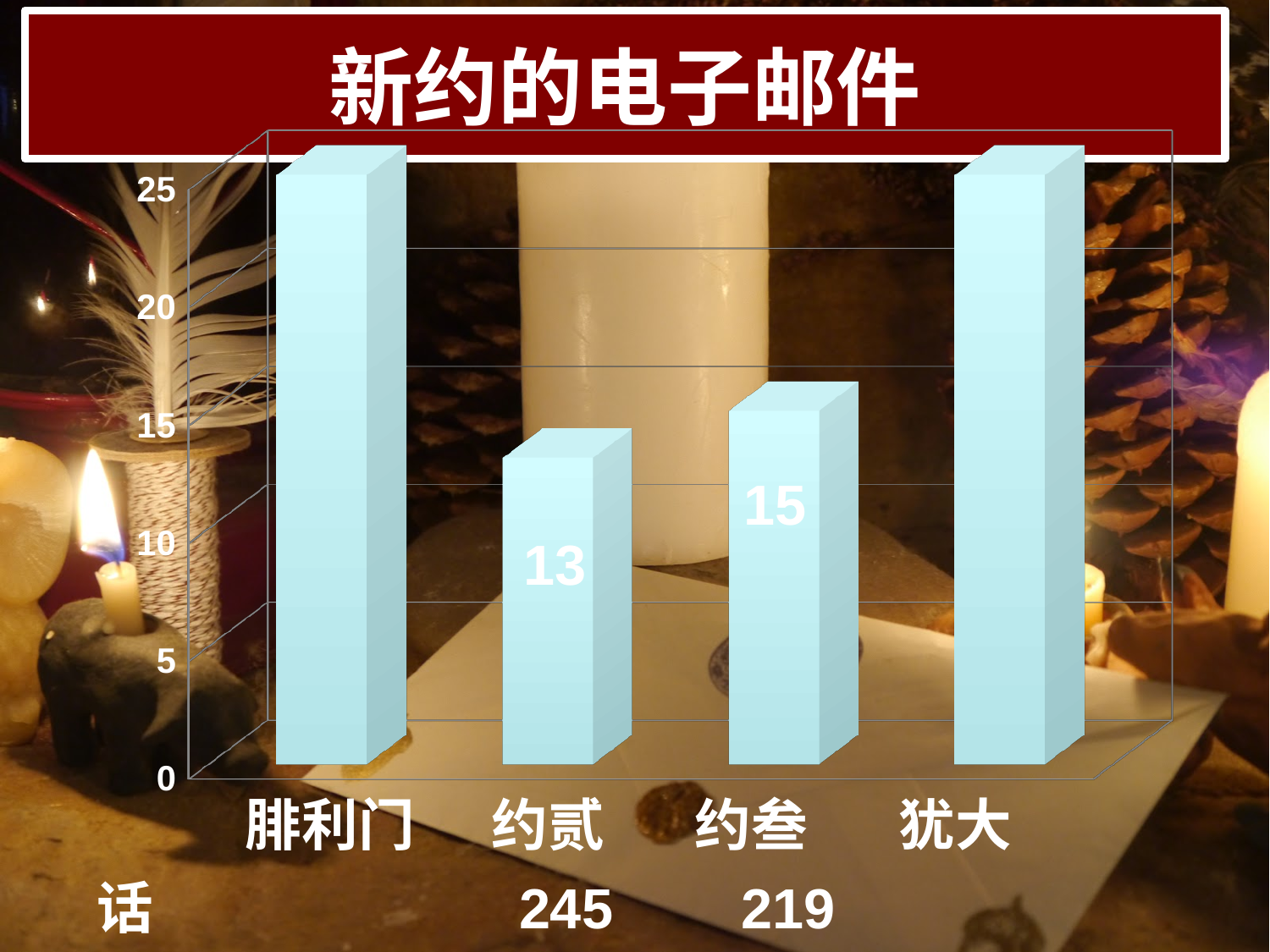
Is the value for 犹大 greater or less than 20? greater What kind of chart is shown on the slide? bar chart What is the value for 约叁? 15 How many categories are shown on the x axis? 4 What is the highest value shown on the vertical axis? 25 What is the difference between the values for 约叁 and 约贰? 2 Is the value for 腓利门 greater or less than 20? greater Is the value for 约贰 greater or less than 15? less What is the value for 约贰? 13 Which category has the lowest value? 约贰 What is the title of the slide? 新约的电子邮件 Which is larger, the value for 约贰 or the value for 约叁? 约叁